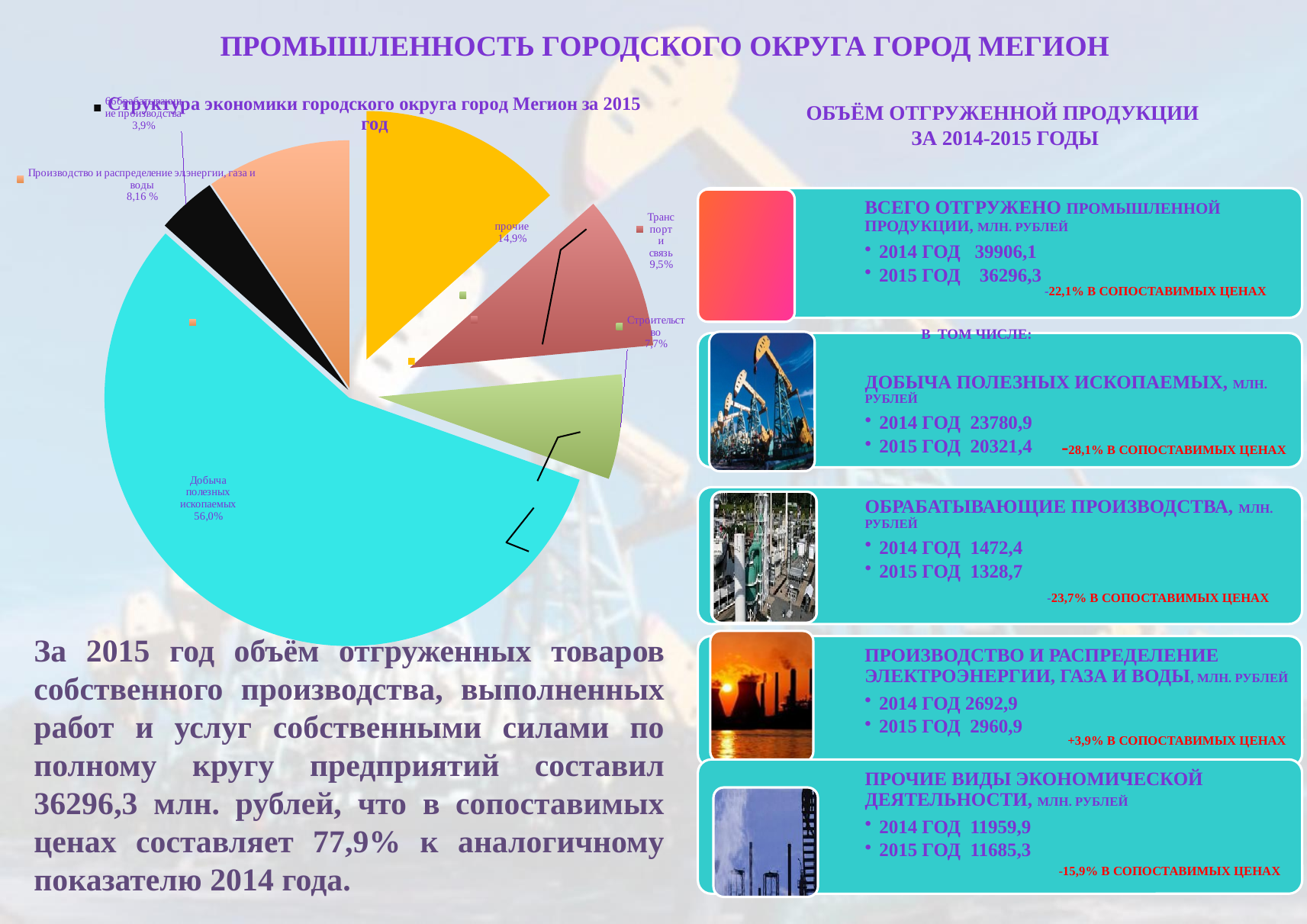
What share of the pie chart does "Добыча полезных ископаемых" have? 56,0% How many slices does the pie chart have? 6 Which category has the largest slice in the pie chart? Добыча полезных ископаемых By how many percentage points does the "Добыча полезных ископаемых" slice exceed the "прочие" slice? 41,1 What is the title of the pie chart? Структура экономики городского округа город Мегион за 2015 год What share of the pie chart does "прочие" have? 14,9% Which slice is larger in the pie chart: "Транспорт и связь" or "Строительство"? Транспорт и связь What kind of chart is shown on the slide? Pie chart What share of the pie chart does "Строительство" have? 7,7% What share of the pie chart does "Производство и распределение электроэнергии, газа и воды" have? 8,16 % What share of the pie chart does "Транспорт и связь" have? 9,5% Which category has the smallest slice in the pie chart? Обрабатывающие производства